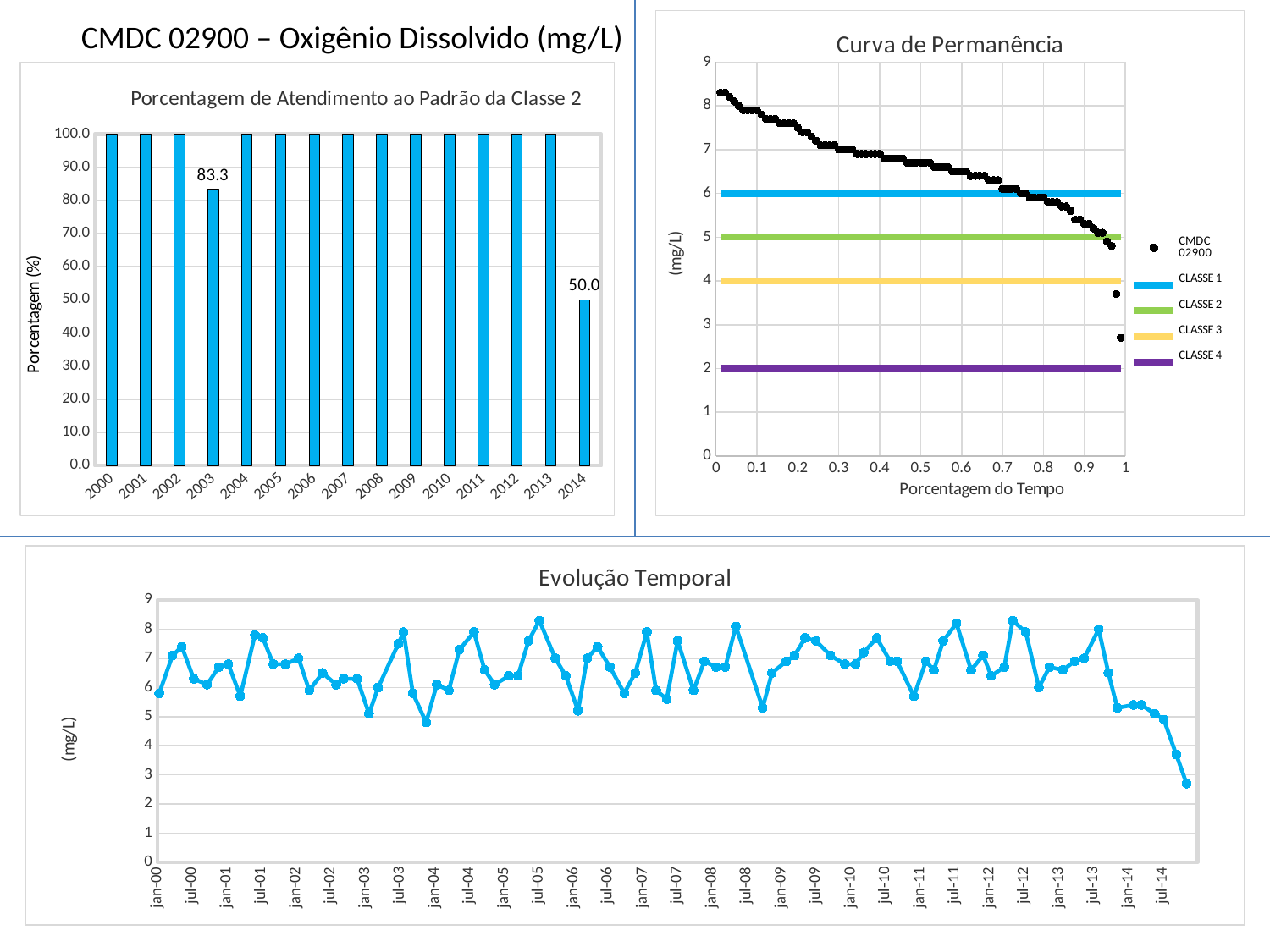
How many bars are shown in the 'Porcentagem de Atendimento ao Padrão da Classe 2' chart? 15 In the 'Porcentagem de Atendimento ao Padrão da Classe 2' chart, what is the value for 2003? 83.3 How many entries does the legend of the 'Curva de Permanência' chart list? 5 In the 'Evolução Temporal' chart, is the value of the last point (after jul-14) greater or less than 4? less In the 'Porcentagem de Atendimento ao Padrão da Classe 2' chart, which is larger, the value for 2003 or the value for 2014? 2003 In the 'Porcentagem de Atendimento ao Padrão da Classe 2' chart, what is the difference between the values for 2003 and 2014? 33.3 In the 'Curva de Permanência' chart, at what value (mg/L) is the CLASSE 1 line drawn? 6 What kind of chart is 'Porcentagem de Atendimento ao Padrão da Classe 2'? Bar chart In the 'Porcentagem de Atendimento ao Padrão da Classe 2' chart, which year has the lowest value? 2014 In the 'Curva de Permanência' chart, at what value (mg/L) is the CLASSE 4 line drawn? 2 In the 'Porcentagem de Atendimento ao Padrão da Classe 2' chart, what is the value for 2014? 50.0 In the 'Curva de Permanência' chart, do the CMDC 02900 values rise or fall along the x axis? Fall